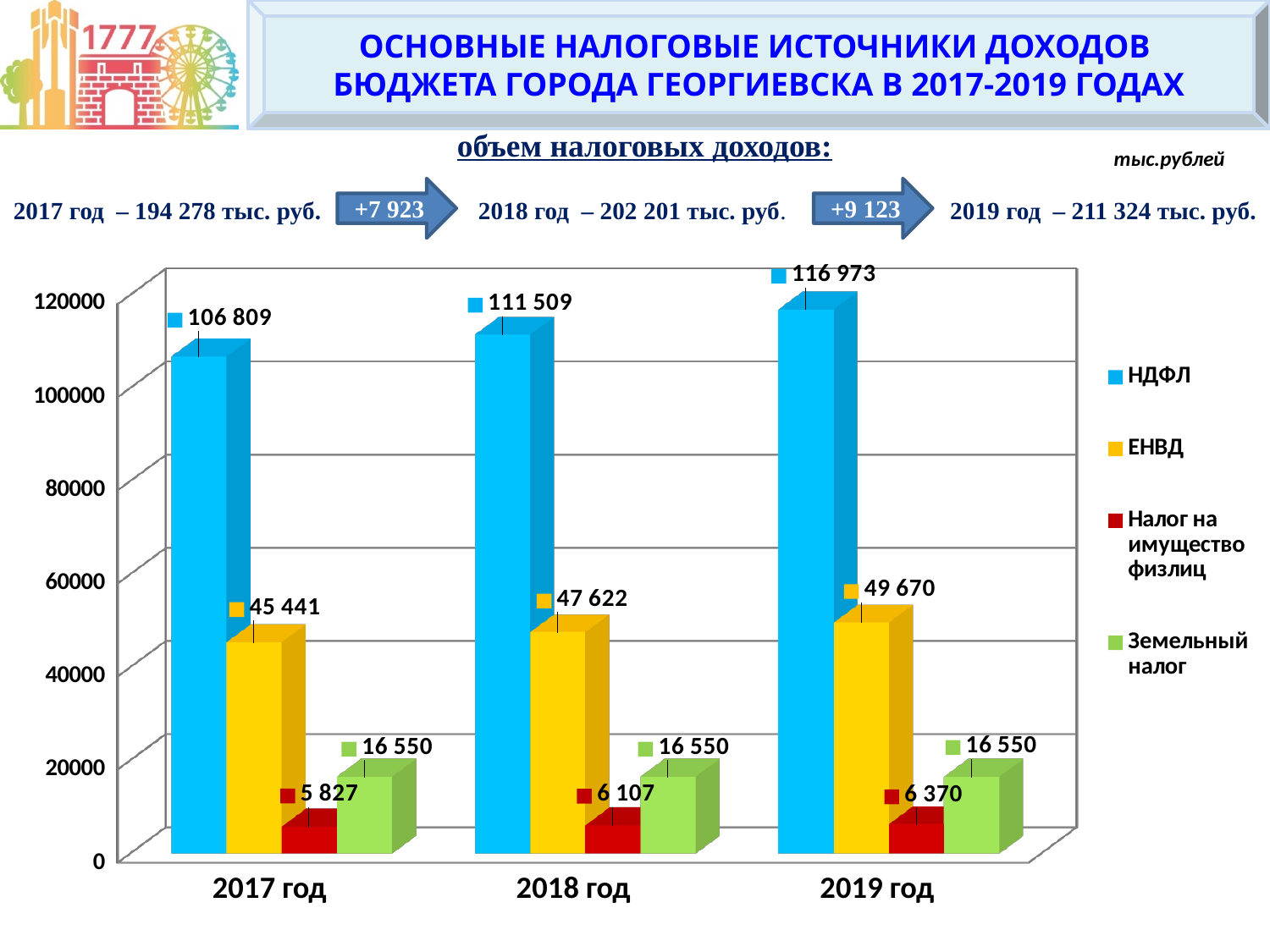
Does the value of Налог на имущество физлиц rise or fall from 2017 год to 2019 год? Rise What is the value of Земельный налог for 2019 год? 16 550 How many year categories are shown on the x axis? 3 What is the difference between НДФЛ in 2019 год and НДФЛ in 2018 год? 5 464 Which is larger: ЕНВД in 2018 год or ЕНВД in 2019 год? ЕНВД in 2019 год What kind of chart is shown on the slide? Bar chart How many series does the legend list? 4 Which series has the lowest value in 2017 год? Налог на имущество физлиц What is the value of НДФЛ for 2019 год? 116 973 What is the value of ЕНВД for 2017 год? 45 441 In which year is НДФЛ highest? 2019 год What is the value of Налог на имущество физлиц for 2018 год? 6 107